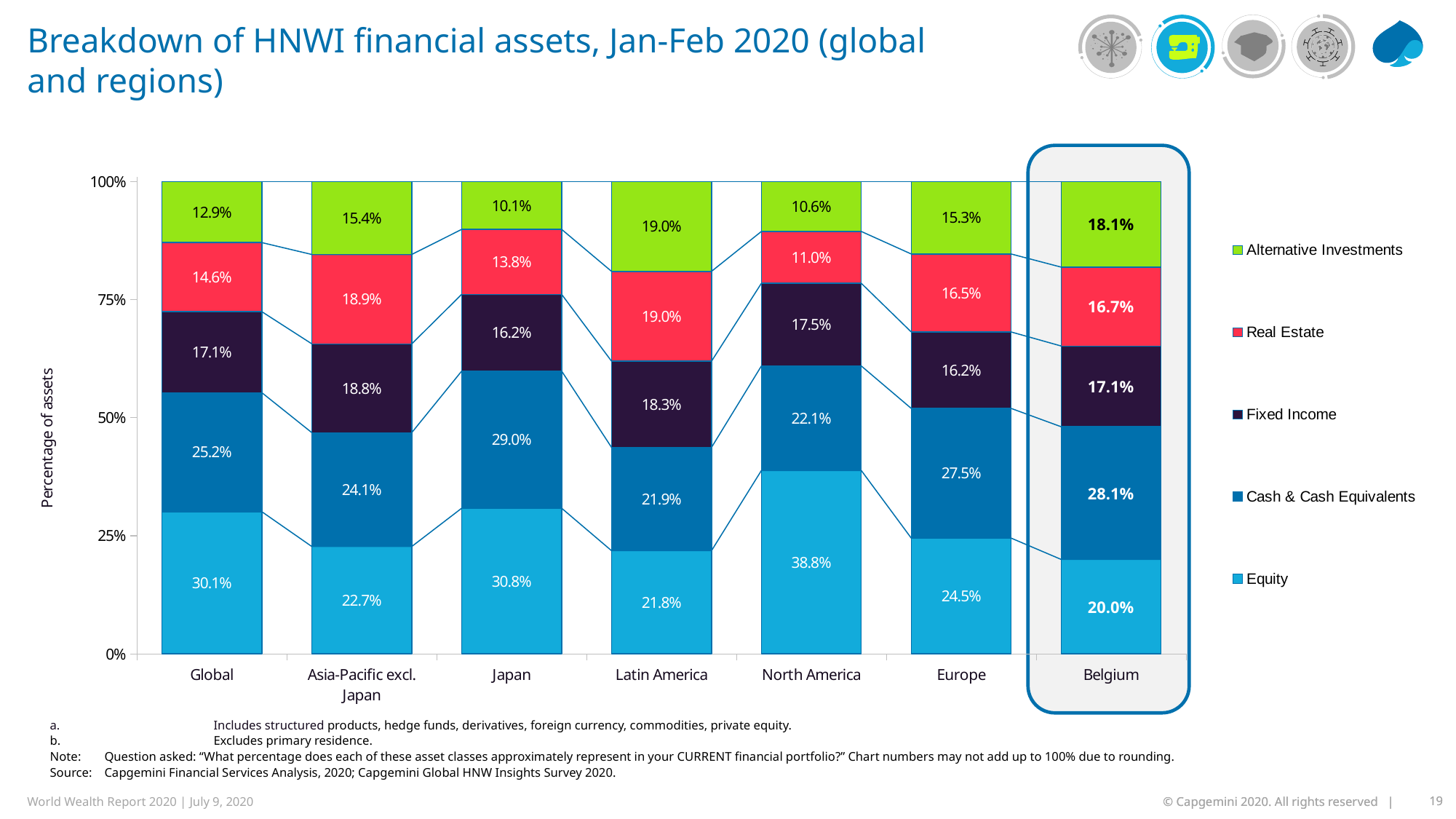
What is the Fixed Income share for Latin America? 18.3% How many asset classes does the legend list? 5 What is the Equity share for North America? 38.8% Which region has the lowest Alternative Investments share? Japan What is the Alternative Investments share for Belgium? 18.1% What is the difference between the Equity share for Japan and for Latin America? 9.0 percentage points What kind of chart is shown on the slide? Stacked bar chart Which region has the highest Equity share? North America How much larger is the Cash & Cash Equivalents share for Belgium than for Global? 2.9 percentage points Which has a larger Real Estate share, Asia-Pacific excl. Japan or Europe? Asia-Pacific excl. Japan How many regions (bars) are shown on the x axis? 7 Which region's bar is highlighted with a rounded box? Belgium